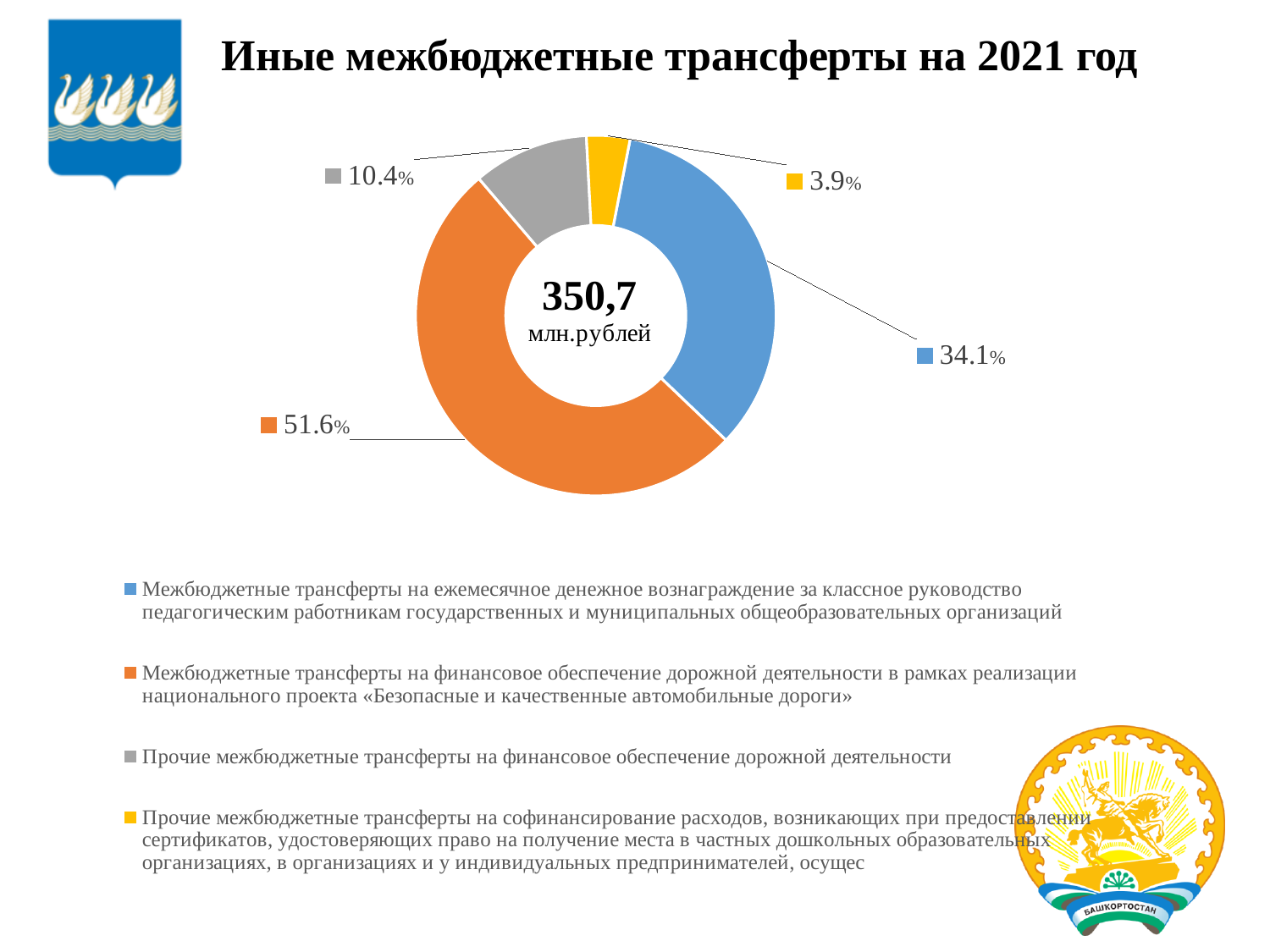
What share of the chart is taken by the orange slice (transfers for road activity under the national project «Безопасные и качественные автомобильные дороги»)? 51.6% What share of the chart is taken by the gray slice (other transfers for financial support of road activity)? 10.4% What is the difference in percentage points between the orange slice (51.6%) and the blue slice (34.1%)? 17.5 What kind of chart is shown on the slide? doughnut (pie) chart What total value is shown in the centre of the chart? 350,7 млн.рублей Which is larger: the gray slice or the yellow slice? the gray slice (10.4%) Which category has the smallest share of the chart? Прочие межбюджетные трансферты на софинансирование расходов, возникающих при предоставлении сертификатов What share of the chart is taken by the yellow slice (other transfers for co-financing of certificates for private preschool organisations)? 3.9% Which category has the largest share of the chart? Межбюджетные трансферты на финансовое обеспечение дорожной деятельности в рамках реализации национального проекта «Безопасные и качественные автомобильные дороги» What share of the chart is taken by the blue slice (transfers for monthly remuneration for class leadership to teachers)? 34.1% How many slices does the chart have? 4 What is the title of the slide? Иные межбюджетные трансферты на 2021 год